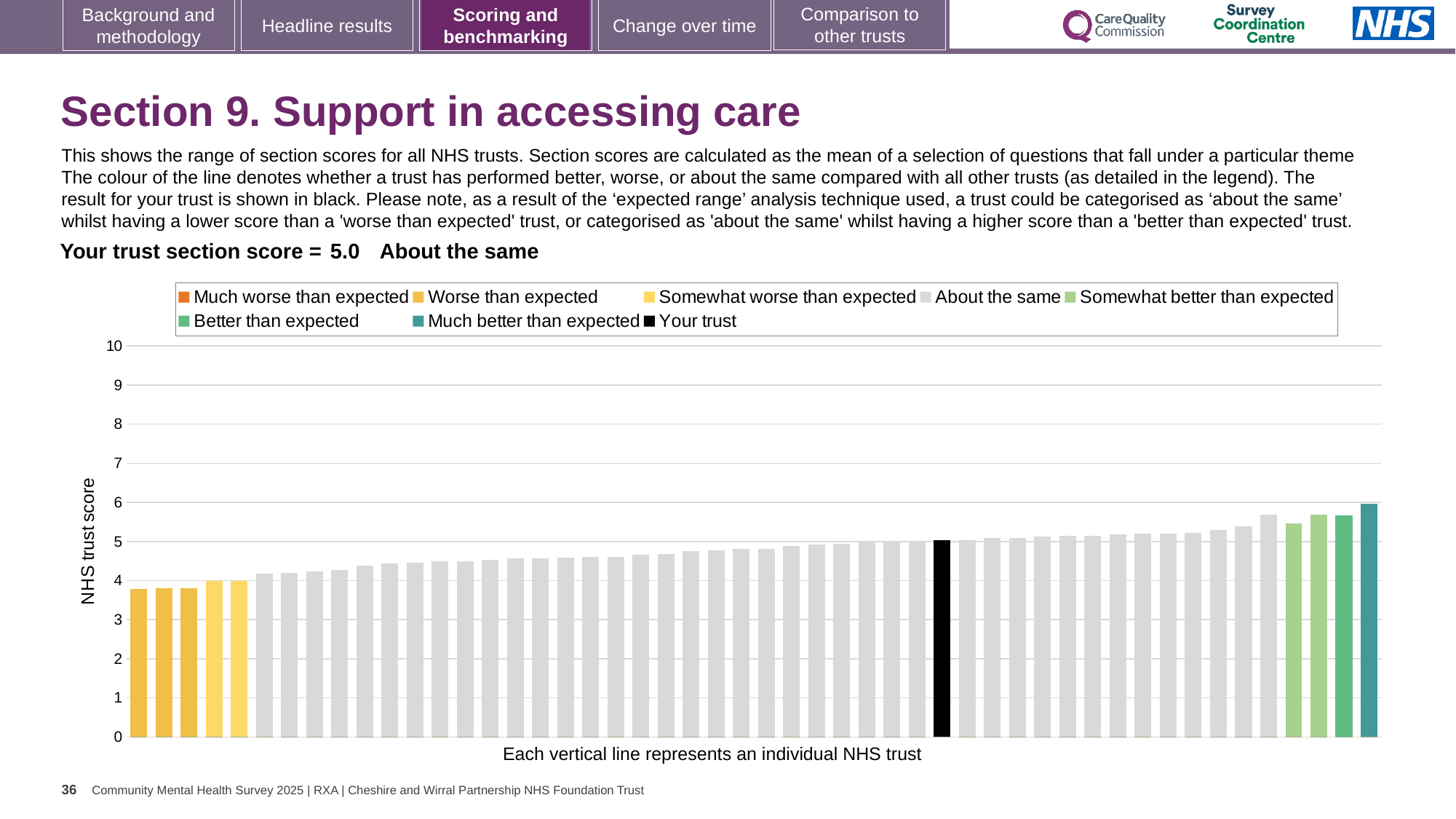
What is the label of the y axis? NHS trust score Is the value of the tallest bar greater or less than 7? less Which bar is taller: the black 'Your trust' bar or the leftmost bar? the black 'Your trust' bar Is the value of the leftmost bar greater or less than 4? less How many categories does the chart legend list? 8 Is the value of the rightmost bar greater or less than 5? greater What is the section score for your trust shown on the chart? 5.0 Which legend category does the colour of the rightmost bar correspond to? Much better than expected Do the bar values rise or fall from left to right along the x axis? rise What is the highest value shown on the y axis? 10 What kind of chart is shown on the slide? bar chart